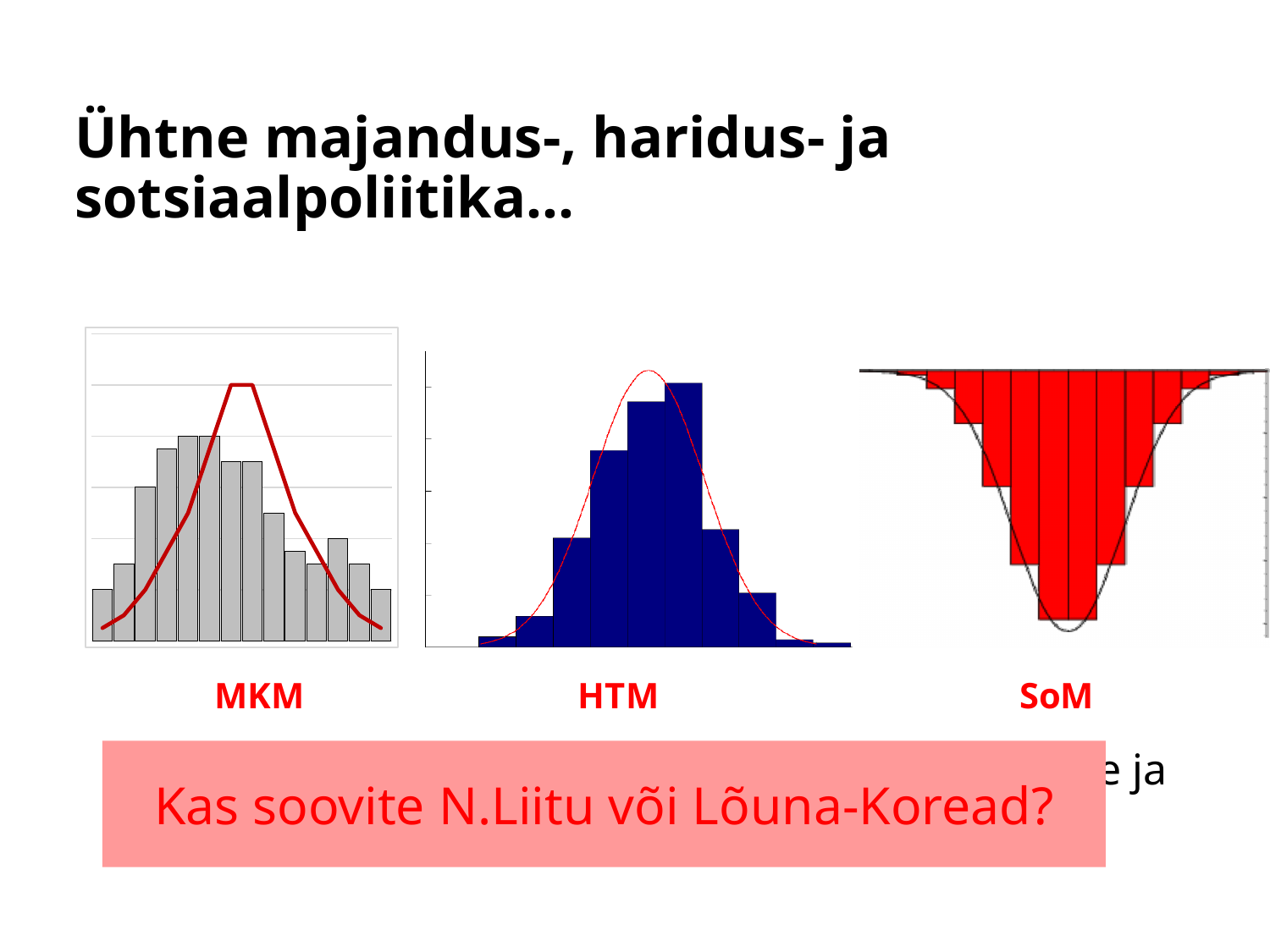
In the HTM chart, do the bar heights rise or fall from the left edge to the tallest bar? rise In the SoM chart, do the bars extend upward or downward from the axis? downward How many bars does the MKM chart have? 14 In the MKM chart, do the bar heights rise or fall from the tallest bars to the right edge? fall What colour are the bars in the HTM chart? dark blue What kind of chart is the MKM chart? bar and line chart How many bars does the HTM chart have? 10 In the HTM chart, which bar from the left is the tallest? the 6th bar What kind of chart is the HTM chart? bar chart